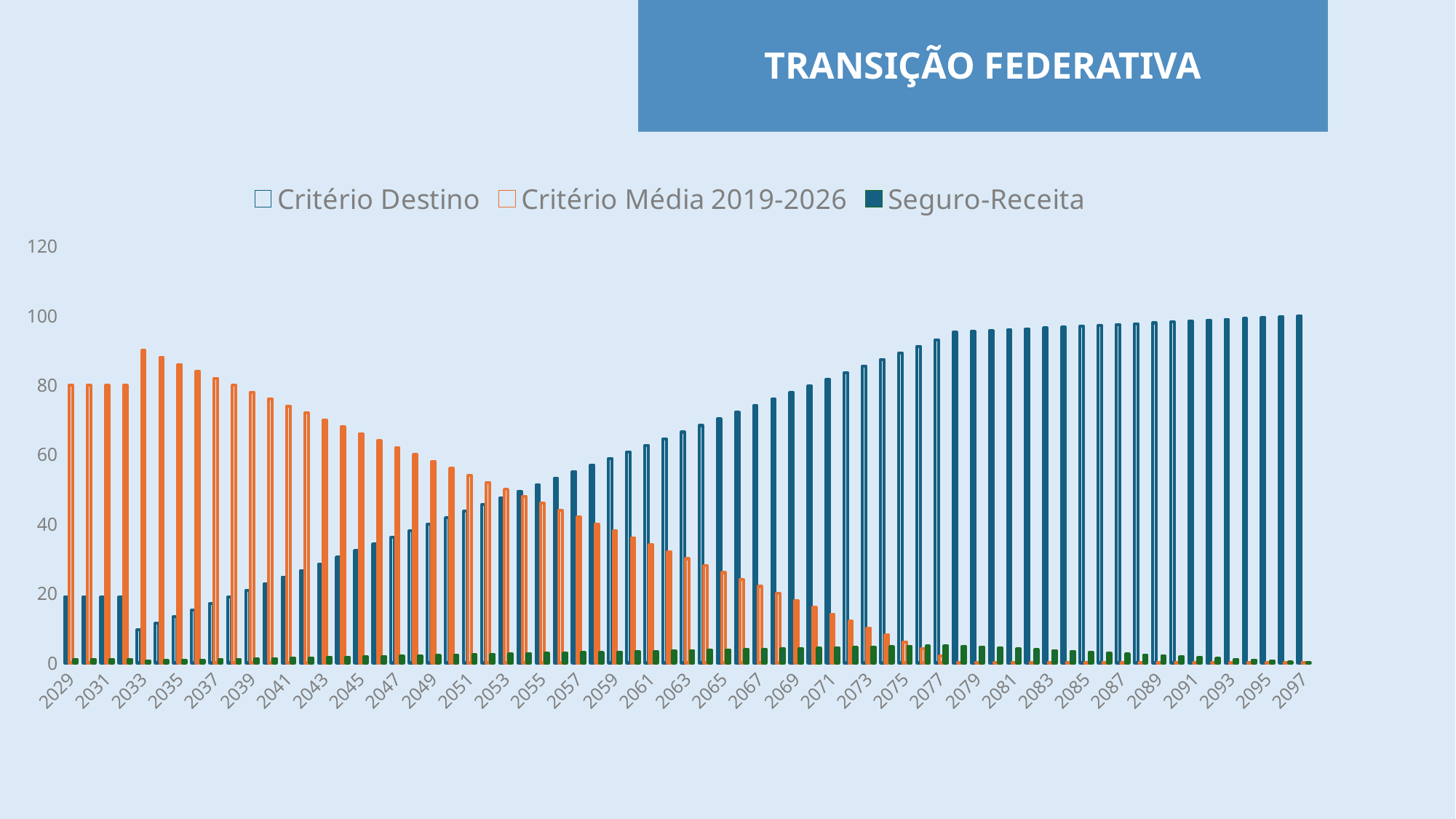
Is the Critério Média 2019-2026 value for 2065 greater or less than 40? less Which series in the legend is shown in orange? Critério Média 2019-2026 Is the Critério Destino value for 2033 greater or less than 20? less Is the Critério Destino value for 2097 greater or less than 80? greater What kind of chart is shown on the slide? bar chart Do the Critério Média 2019-2026 values generally rise or fall from 2033 to 2097? fall How many series does the chart legend list? 3 In 2029, which is larger: Critério Destino or Critério Média 2019-2026? Critério Média 2019-2026 What is the title shown on the slide above the chart? TRANSIÇÃO FEDERATIVA In 2097, which is larger: Critério Destino or Critério Média 2019-2026? Critério Destino